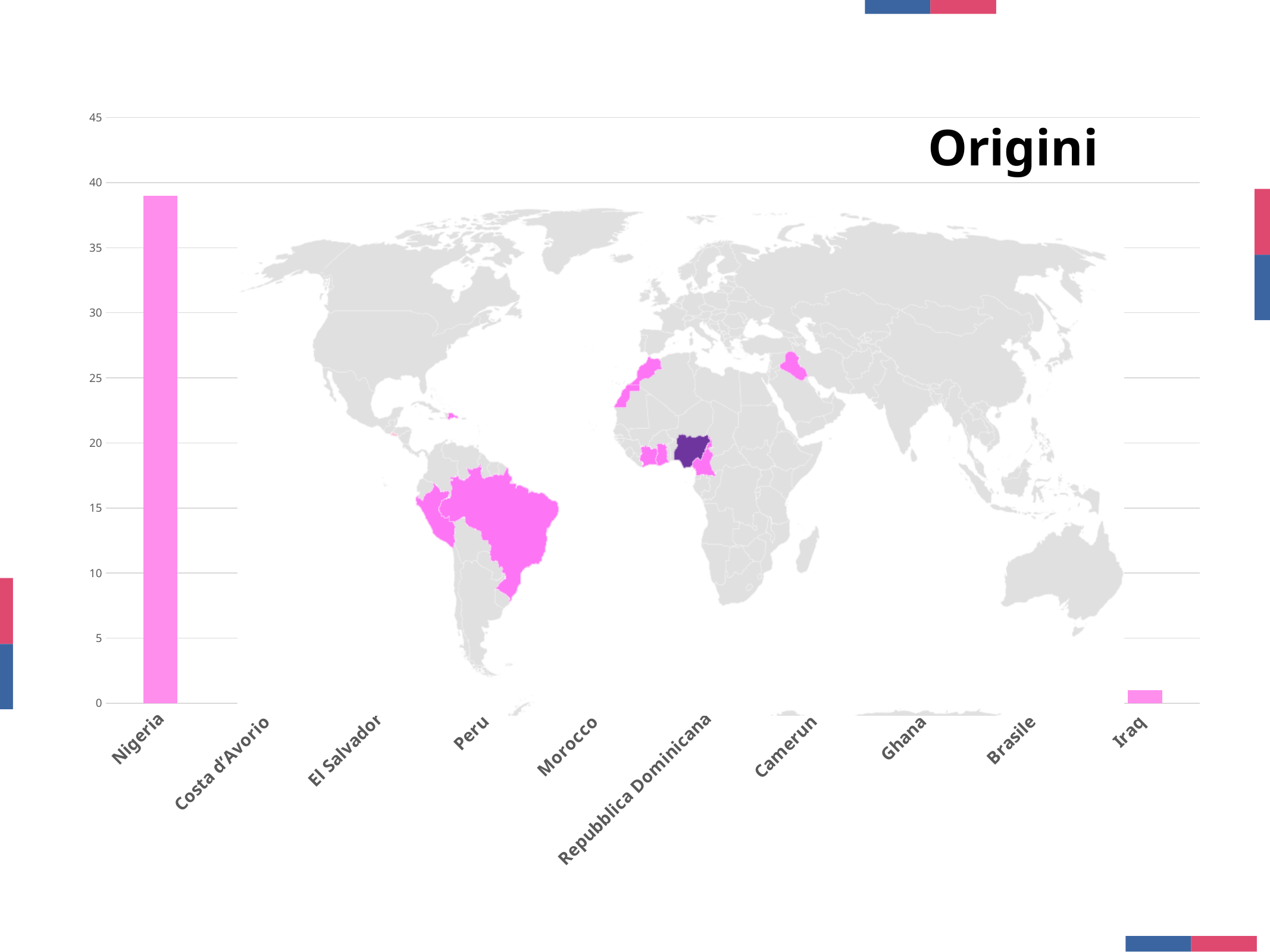
Is the value for Nigeria greater or less than 40? less Is the value for Nigeria greater or less than 35? greater Which is larger, the value for Nigeria or the value for Iraq? Nigeria What kind of chart is shown on the slide? bar chart Which category has the highest bar in the chart? Nigeria What is the title of the slide containing the chart? Origini What is the highest value shown on the vertical axis of the chart? 45 Is the value for Iraq greater or less than 5? less Which category appears first on the x axis of the chart? Nigeria How many categories are listed on the x axis of the chart? 10